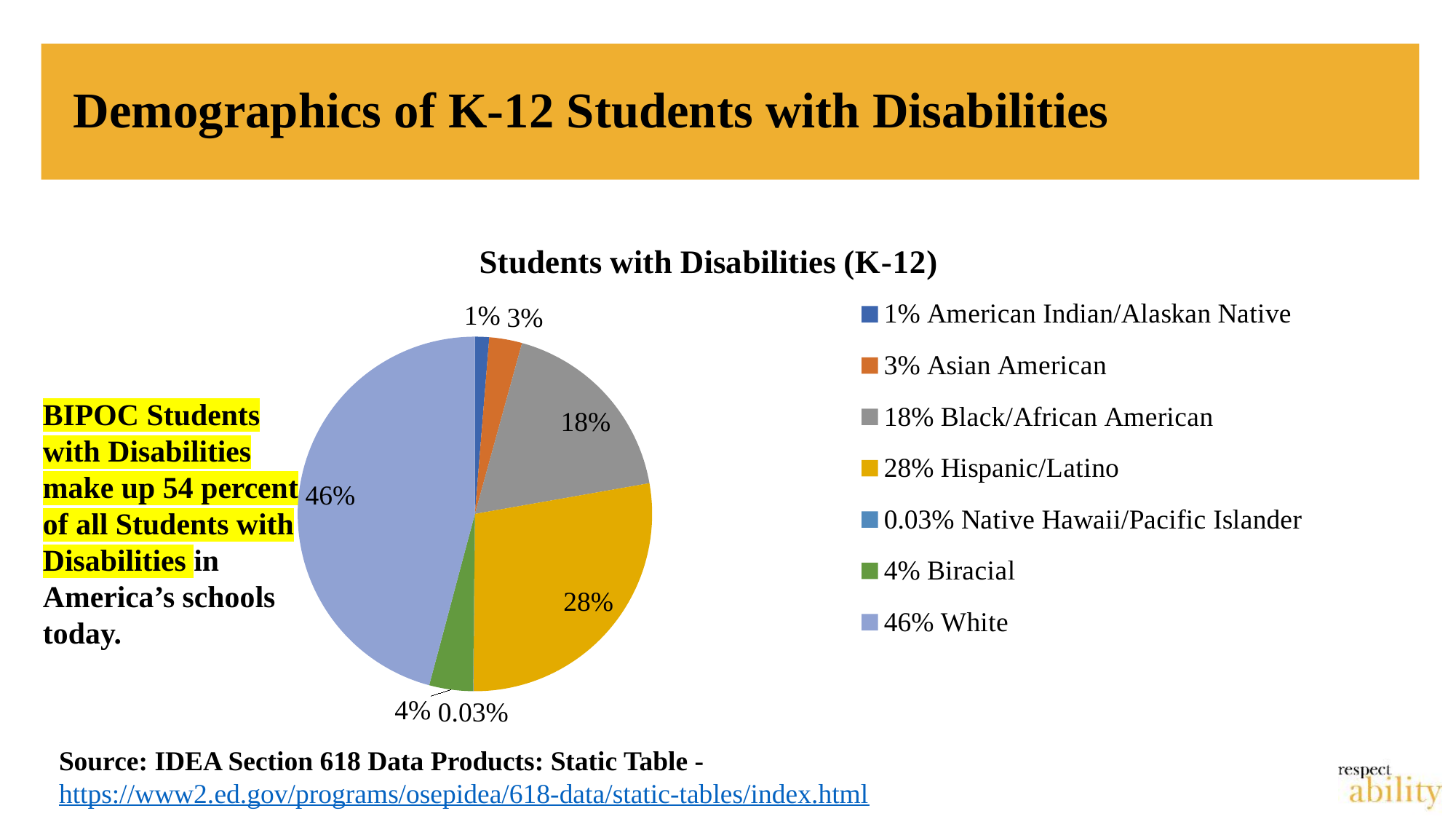
What type of chart is shown on the slide? Pie chart What is the title of the chart? Students with Disabilities (K-12) Which is larger, the Biracial slice or the Asian American slice? Biracial What is the combined share of the Black/African American and Hispanic/Latino slices? 46% What percentage of students with disabilities are Hispanic/Latino? 28% How many categories does the pie chart have? 7 What percentage of students with disabilities are Black/African American? 18% What colour is the White slice in the pie chart? Light blue/lavender Which category has the largest share of the pie? White What percentage of students with disabilities are Native Hawaii/Pacific Islander? 0.03% Which category has the smallest share of the pie? Native Hawaii/Pacific Islander What is the difference in percentage points between the White and Hispanic/Latino slices? 18